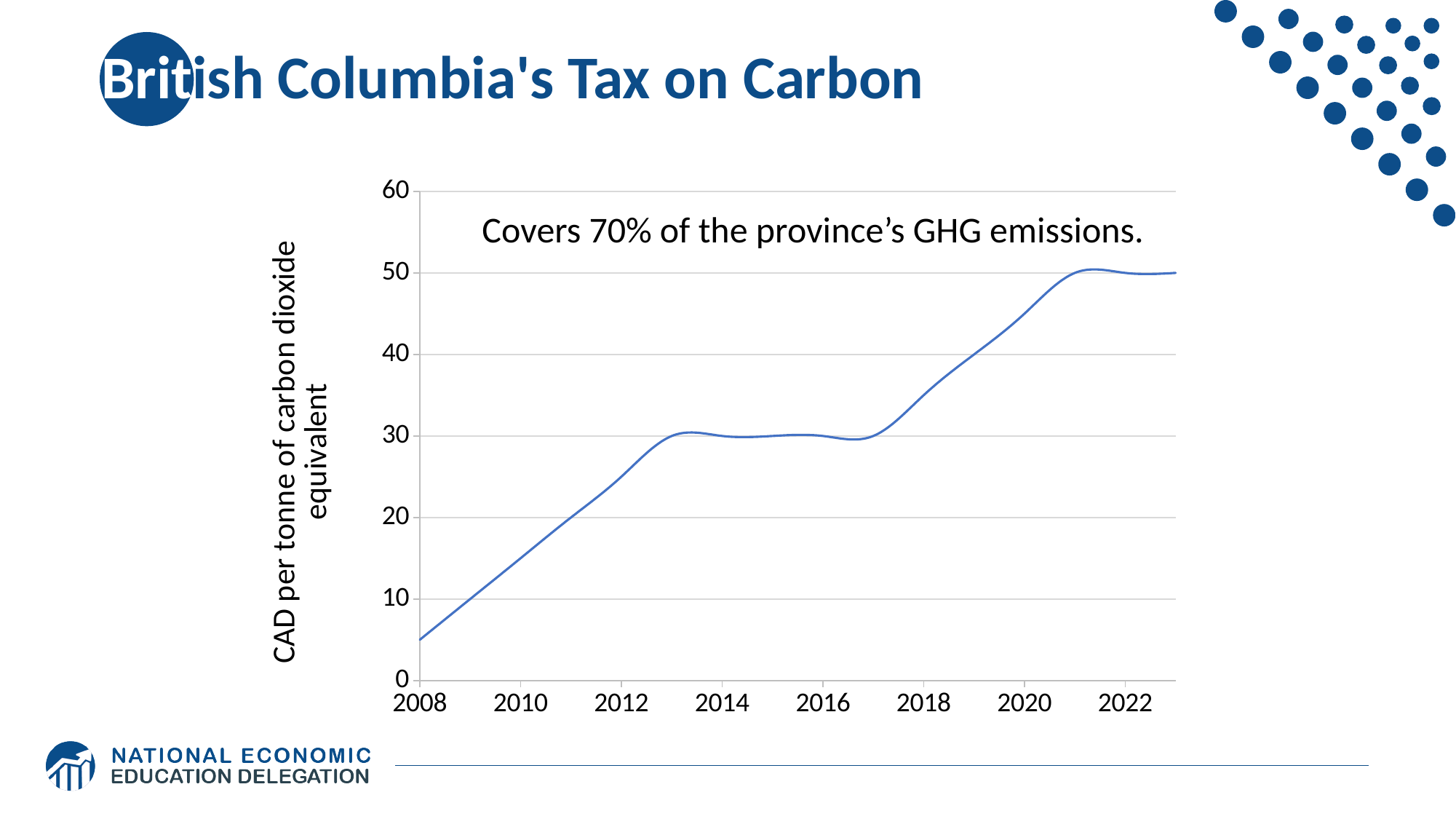
What is the y-axis label of the chart? CAD per tonne of carbon dioxide equivalent What kind of chart is shown on the slide? line chart Does the value rise or fall from 2008 to 2012? rise Is the value for 2008 greater or less than 10? less Is the value for 2010 greater or less than 20? less Is the value for 2015 greater or less than 40? less Which year has a higher value, 2010 or 2020? 2020 What text annotation appears inside the chart area? Covers 70% of the province's GHG emissions. What is the highest value shown on the y-axis? 60